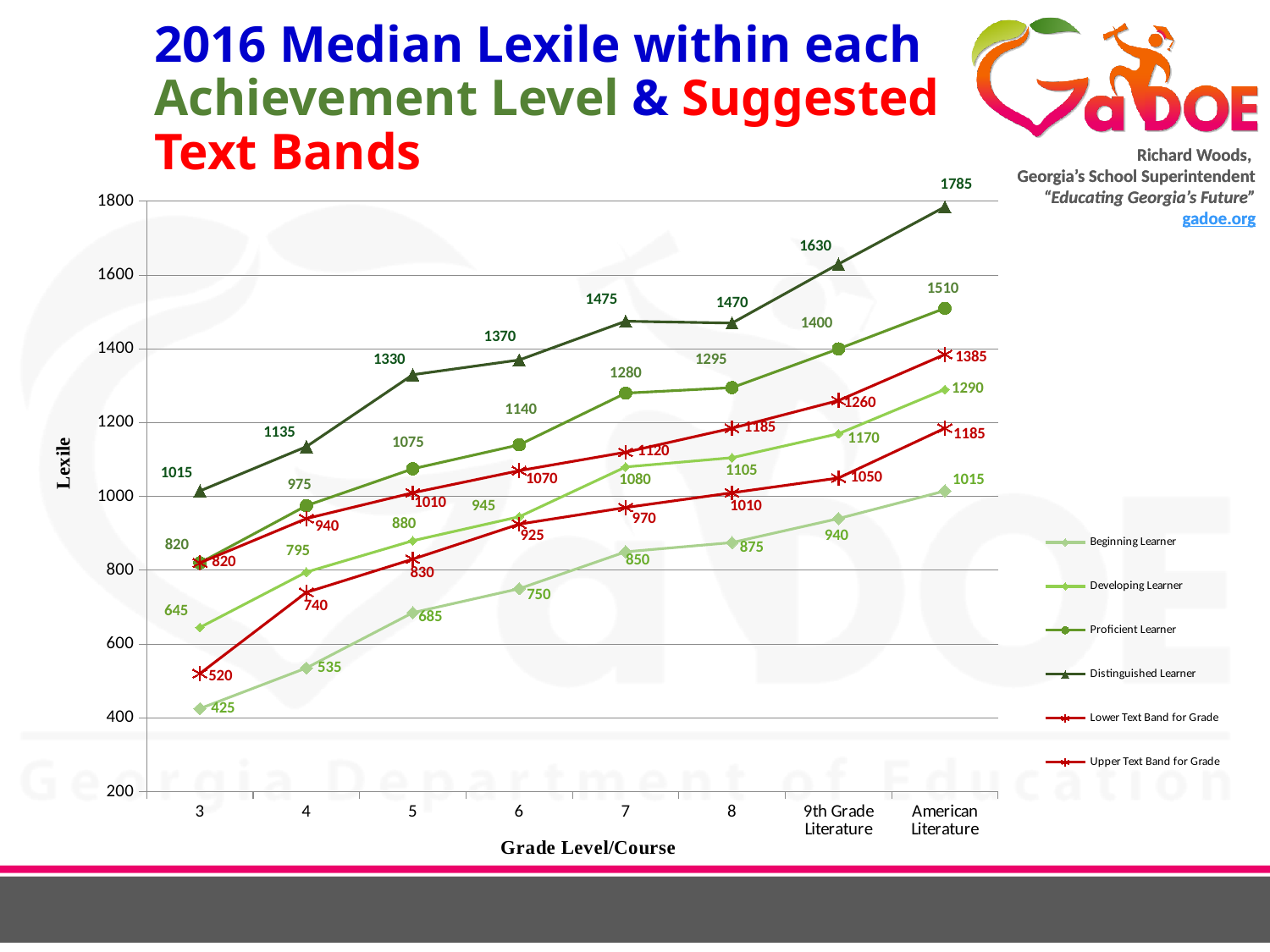
For which grade level/course is the Distinguished Learner value highest? American Literature What is the Beginning Learner value for grade 3? 425 How many grade levels/courses are plotted along the x axis? 8 What is the difference between the Distinguished Learner and Beginning Learner values for American Literature? 770 What is the Lower Text Band for Grade value at grade 5? 830 How many series does the legend list? 6 Do the Proficient Learner values rise or fall from grade 3 to American Literature? rise For which grade level/course is the Beginning Learner value lowest? 3 What is the title of the y axis? Lexile What kind of chart is shown on the slide? line chart What is the Distinguished Learner value for American Literature? 1785 At grade 8, which is larger: the Proficient Learner value or the Upper Text Band for Grade value? Proficient Learner